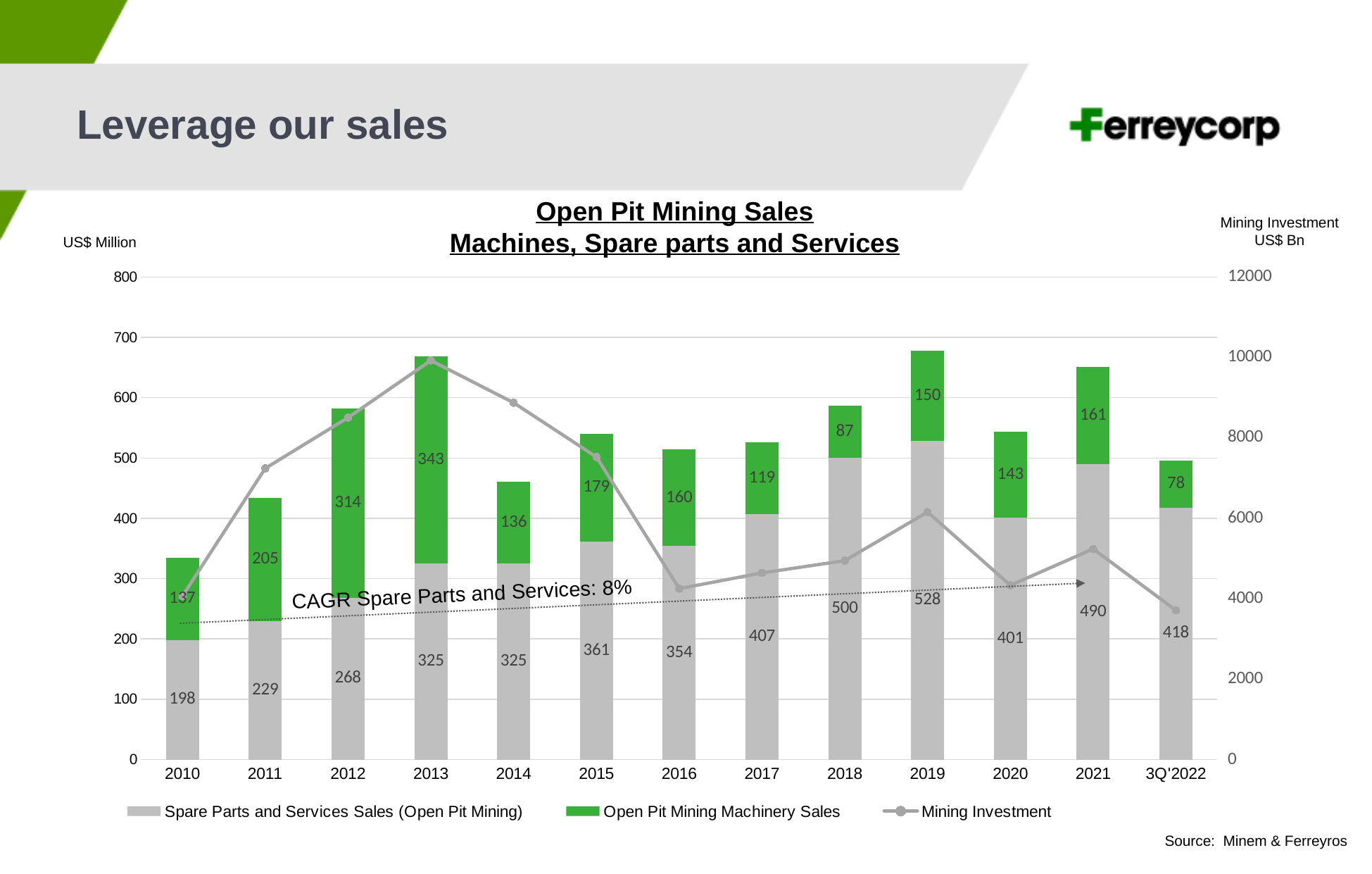
Which year has the highest Spare Parts and Services Sales (Open Pit Mining)? 2019 How many periods are shown on the x axis? 13 Which is larger: Open Pit Mining Machinery Sales in 2012 or in 2014? 2012 What CAGR for Spare Parts and Services is stated on the chart? 8% What is the value of Open Pit Mining Machinery Sales for 2013? 343 What is the value of Spare Parts and Services Sales (Open Pit Mining) for 2019? 528 What is the value of Open Pit Mining Machinery Sales for 3Q'2022? 78 How many series does the legend list? 3 What is the difference between Spare Parts and Services Sales in 2018 and in 2017? 93 Which period has the lowest Open Pit Mining Machinery Sales? 3Q'2022 Is the Mining Investment value for 2013 greater or less than 8000? greater What is the total of the stacked bar for 2019? 678